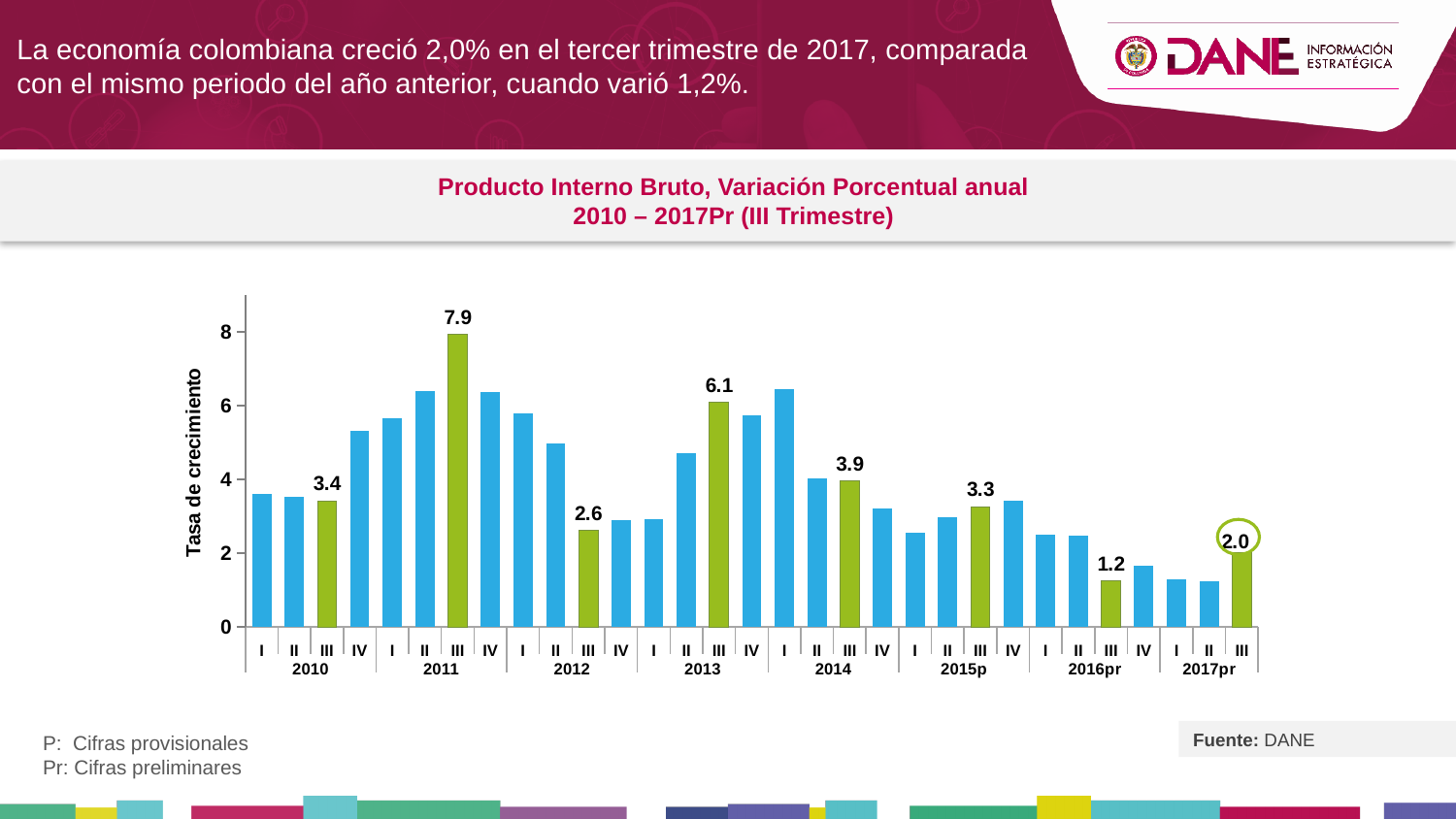
Do the labelled third-quarter values rise or fall from 2013 to 2016pr? fall Is the value for the first quarter (I) of 2014 greater or less than 6? greater Which is larger: the third-quarter value of 2013 or the third-quarter value of 2014? III 2013 What is the difference between the third-quarter values of 2011 and 2013? 1.8 What is the value for the third quarter (III) of 2013? 6.1 Is the value for the fourth quarter (IV) of 2016pr greater or less than 2? less What is the value for the third quarter (III) of 2016pr? 1.2 What is the difference between the third-quarter values of 2017pr and 2016pr? 0.8 How many bars are plotted in the chart? 31 What is the value for the third quarter (III) of 2011? 7.9 Which quarter has the highest growth rate in the chart? III 2011 What is the value for the third quarter (III) of 2017pr? 2.0